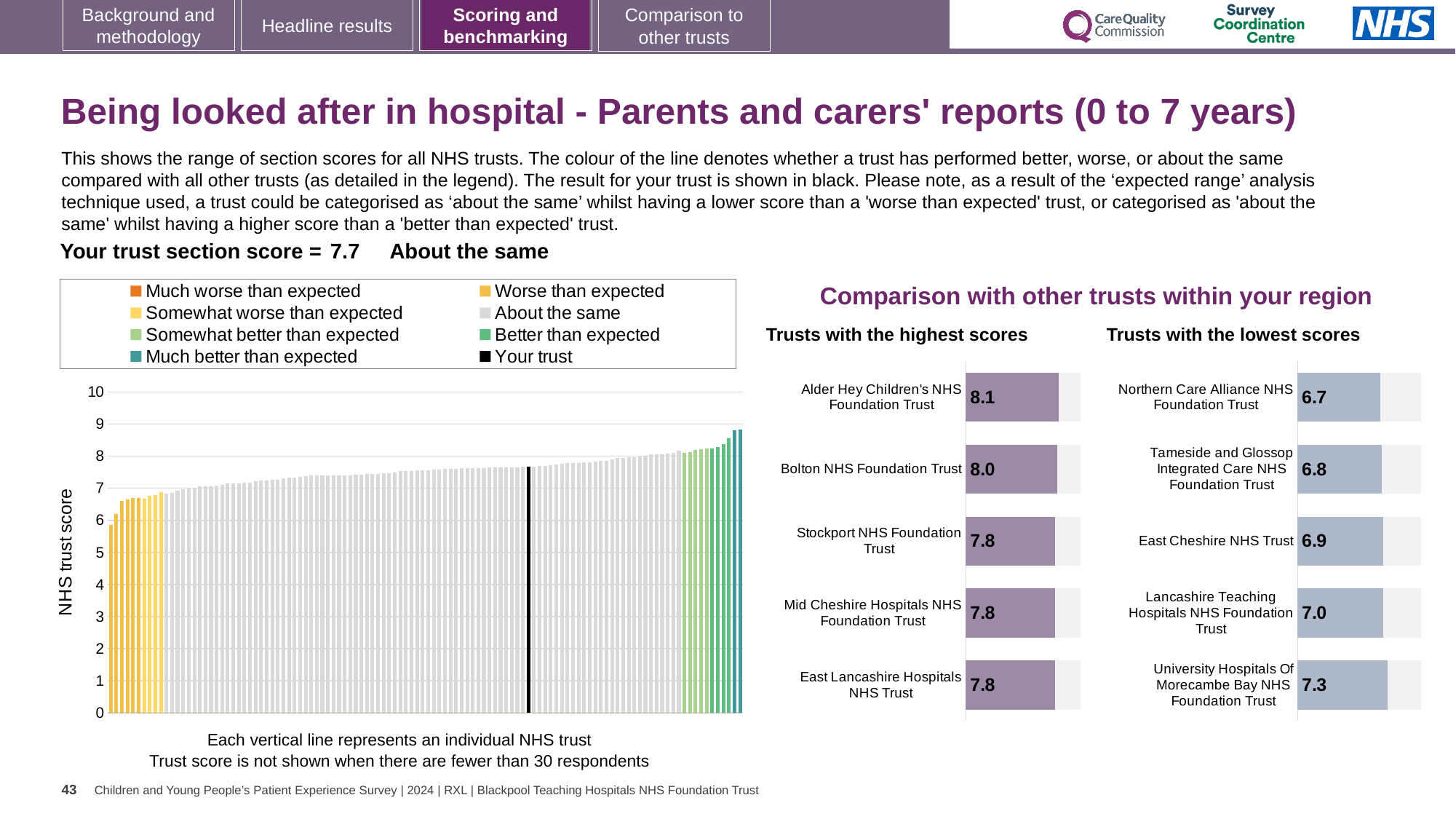
In the 'Trusts with the highest scores' chart, which trust has the highest score? Alder Hey Children's NHS Foundation Trust In the 'Trusts with the highest scores' chart, what is the difference between the scores of Alder Hey Children's NHS Foundation Trust and Bolton NHS Foundation Trust? 0.1 On the main chart of all NHS trusts, is the value for your trust (the black bar) greater or less than 7? greater In the 'Trusts with the lowest scores' chart, how many trusts are shown? 5 On the main chart of all NHS trusts, do the bar values rise or fall from left to right? rise In the 'Trusts with the lowest scores' chart, what is the score for University Hospitals Of Morecambe Bay NHS Foundation Trust? 7.3 On the main chart of all NHS trusts, what is the section score for your trust (the black bar)? 7.7 In the 'Trusts with the lowest scores' chart, which trust has the lowest score? Northern Care Alliance NHS Foundation Trust On the main chart of all NHS trusts, how many entries does the legend list? 8 What kind of chart is the main chart of all NHS trusts on the left of the slide? bar chart In the 'Trusts with the highest scores' chart, what is the score for Alder Hey Children's NHS Foundation Trust? 8.1 On the main chart of all NHS trusts, what is the label on the vertical axis? NHS trust score